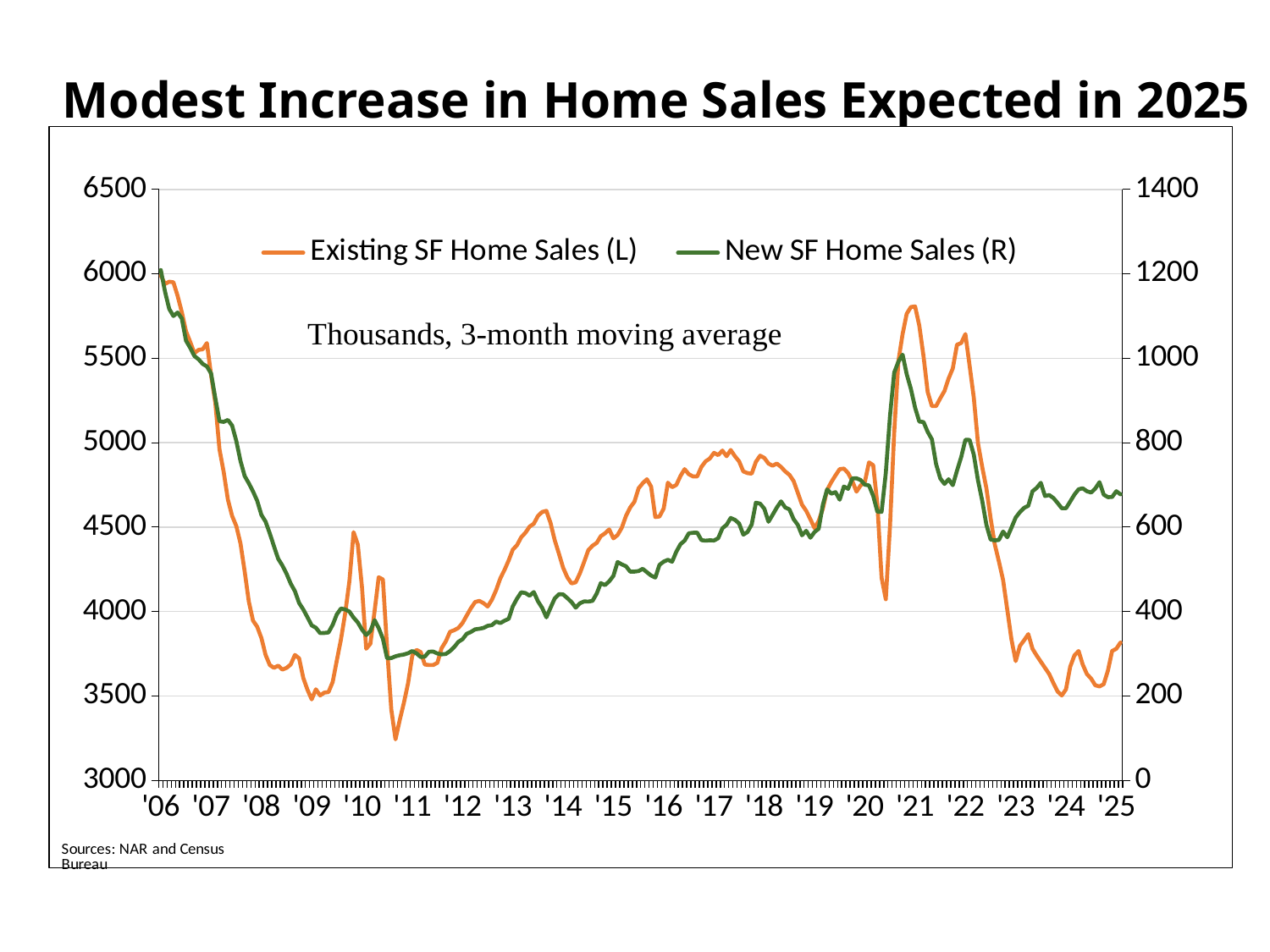
How many series does the legend list? 2 Is the value for New SF Home Sales at its peak around '21 greater or less than 800? greater What is the title of the slide? Modest Increase in Home Sales Expected in 2025 Do Existing SF Home Sales rise or fall from '22 to '24? fall What kind of chart is shown on the slide? Line chart Is the value for New SF Home Sales at the end of the series in '25 greater or less than 600? greater Is the value for Existing SF Home Sales at the end of the series in '25 greater or less than 4000? less Do Existing SF Home Sales rise or fall from '06 to '11? fall Which series is plotted in orange? Existing SF Home Sales (L)